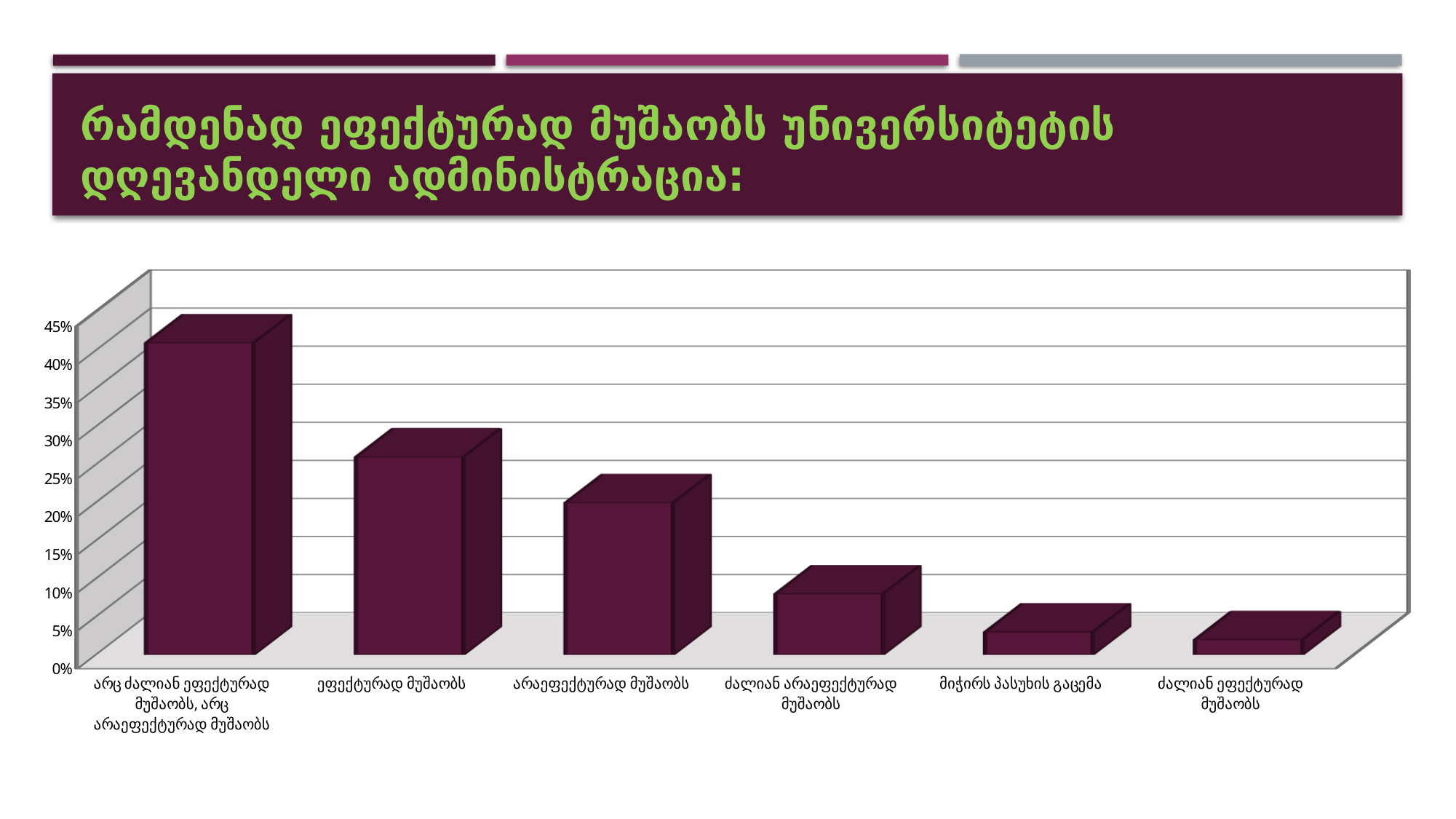
Which is larger, the value for ეფექტურად მუშაობს or the value for არაეფექტურად მუშაობს? ეფექტურად მუშაობს Is the value for არაეფექტურად მუშაობს greater or less than 15%? greater What is the title of the slide? რამდენად ეფექტურად მუშაობს უნივერსიტეტის დღევანდელი ადმინისტრაცია: Is the value for არც ძალიან ეფექტურად მუშაობს, არც არაეფექტურად მუშაობს greater or less than 35%? greater What kind of chart is shown on the slide? bar chart Which category has the highest value in the chart? არც ძალიან ეფექტურად მუშაობს, არც არაეფექტურად მუშაობს Is the value for ძალიან არაეფექტურად მუშაობს greater or less than 15%? less How many categories are shown on the x axis of the chart? 6 Do the values rise or fall from left to right along the x axis? fall Which category has the lowest value in the chart? ძალიან ეფექტურად მუშაობს